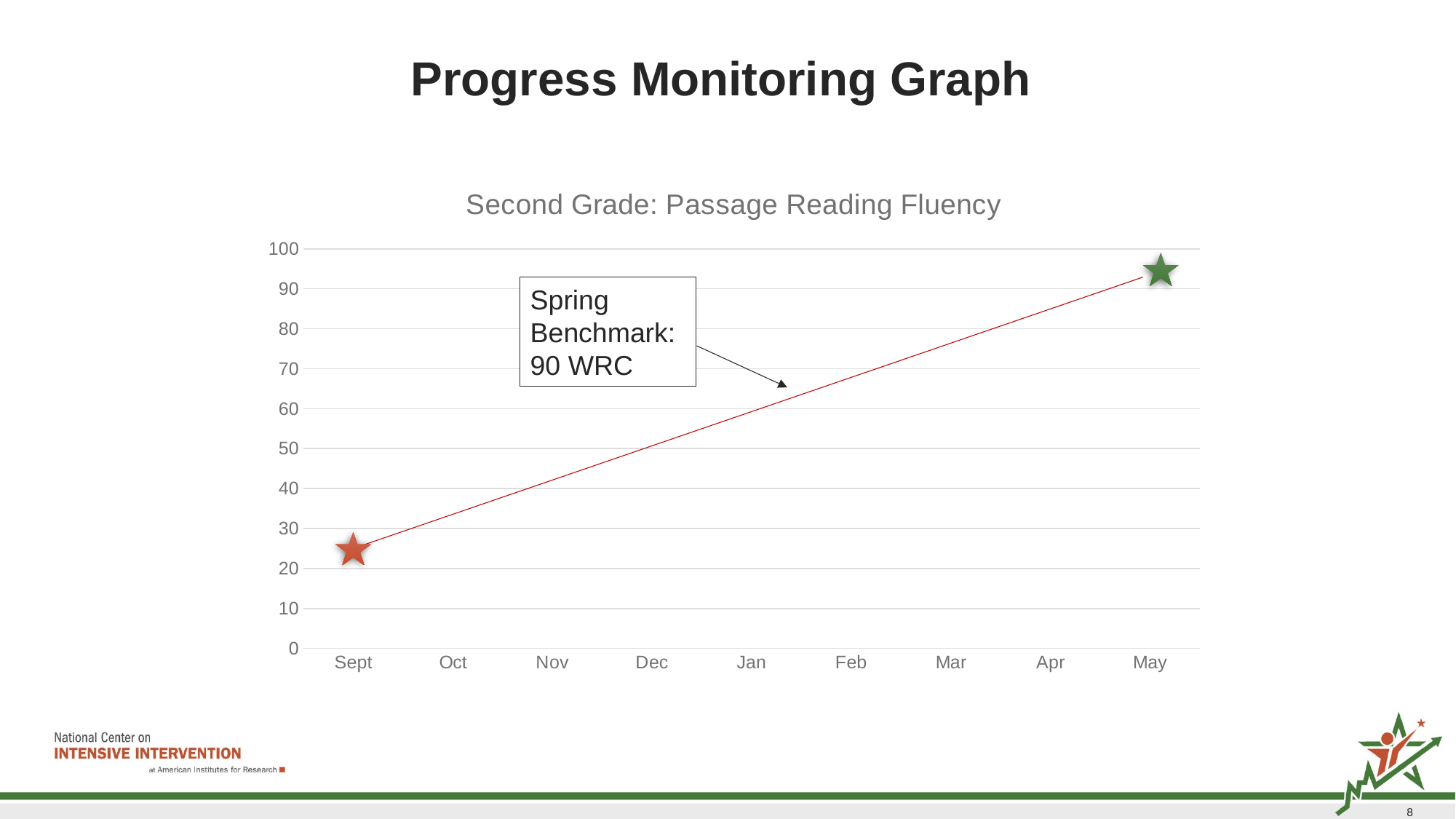
What is the title of the chart? Second Grade: Passage Reading Fluency Is the value for Sept greater or less than 20? greater What Spring Benchmark value is stated in the annotation box on the chart? 90 WRC At which month does the line reach its highest point? May Is the value for May greater or less than 80? greater What kind of chart is shown on the slide? line chart Which month has the higher value, Sept or May? May At which month does the line have its lowest point? Sept Is the value for Sept greater or less than 30? less Does the line rise or fall from Sept to May? rise What is the highest value shown on the y axis? 100 How many months are labelled along the x axis? 9